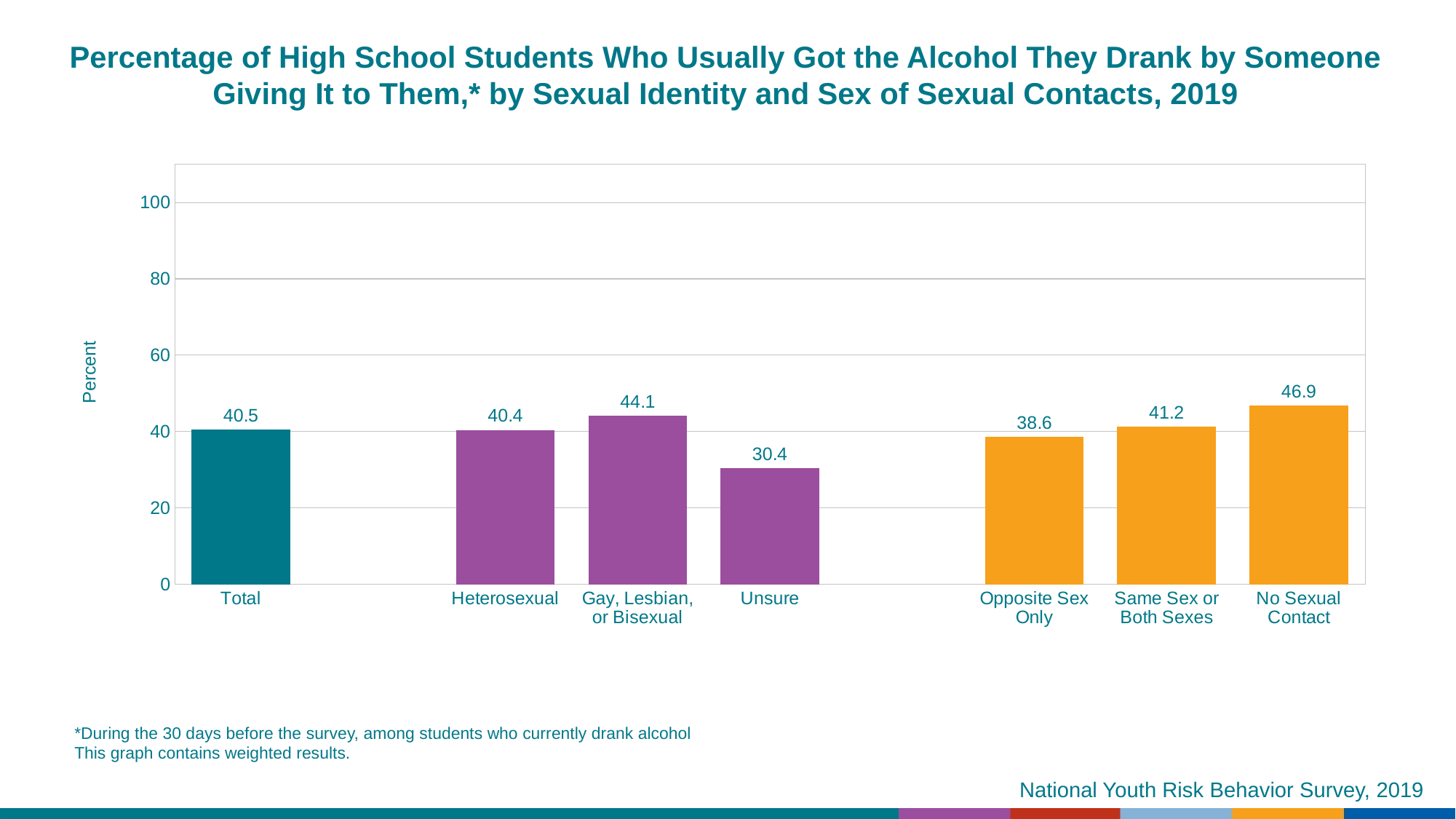
What kind of chart is shown on the slide? bar chart Which is larger, the value for Same Sex or Both Sexes or the value for Opposite Sex Only? Same Sex or Both Sexes Is the value for Unsure greater or less than 40? less What is the value for Unsure? 30.4 What is the label of the y axis? Percent What is the value for No Sexual Contact? 46.9 What is the value for Opposite Sex Only? 38.6 What is the difference between the values for Gay, Lesbian, or Bisexual and Heterosexual? 3.7 Which category has the highest value? No Sexual Contact How many bars are shown in the chart? 7 Which category has the lowest value? Unsure What is the value for Total? 40.5